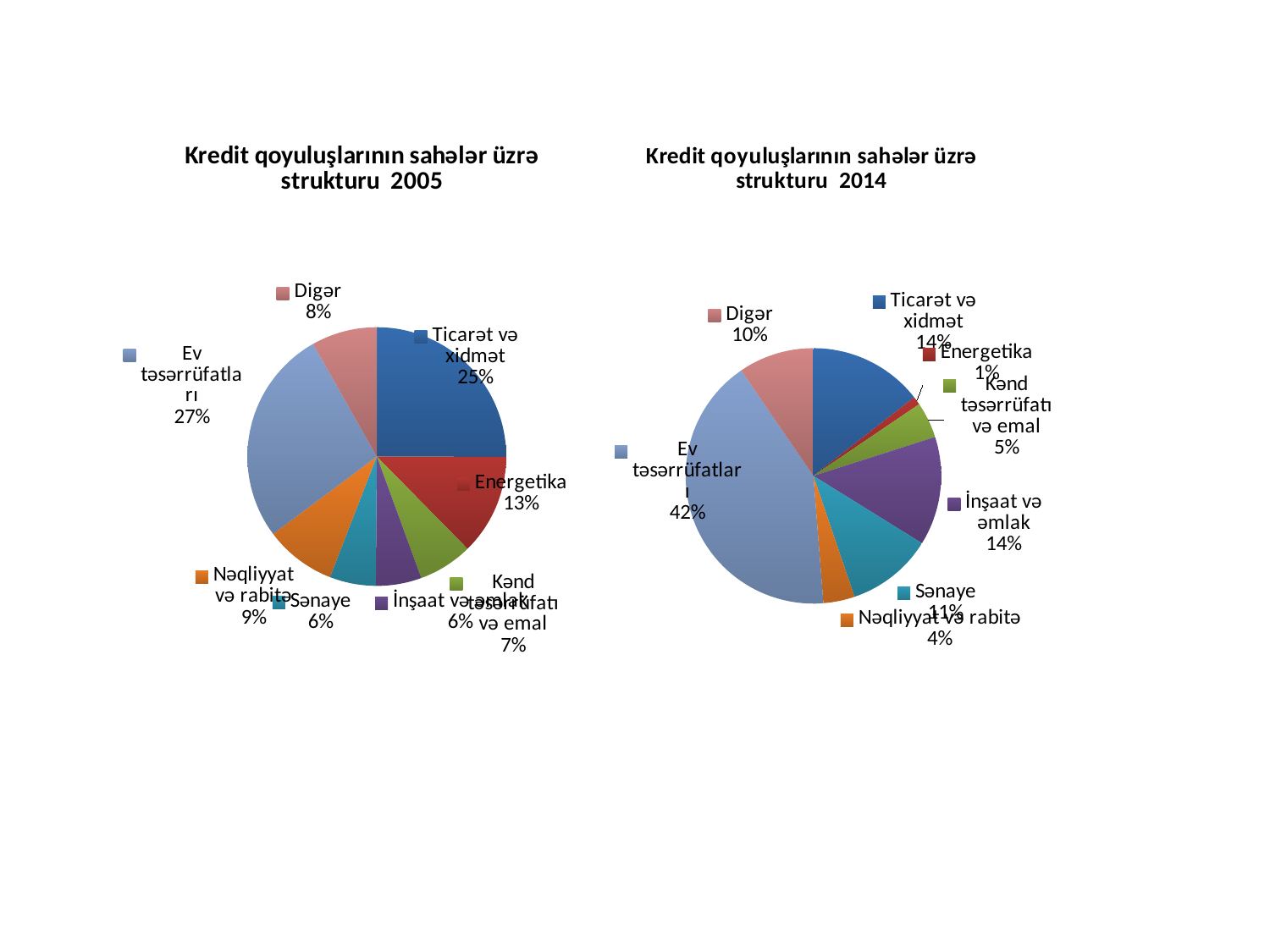
In the 2014 chart, which sector has the smallest share? Energetika In the 2005 chart (Kredit qoyuluşlarının sahələr üzrə strukturu 2005), what share does Ev təsərrüfatları have? 27% What type of chart is used on the slide for the 2005 data? Pie chart How many sectors are shown in the 2014 chart? 8 In the 2014 chart, what share does Energetika have? 1% In the 2014 chart, which is larger: the share of Sənaye or the share of Nəqliyyat və rabitə? Sənaye In the 2005 chart, what share does Ticarət və xidmət have? 25% In the 2005 chart, what is the difference between the shares of Ev təsərrüfatları and Ticarət və xidmət? 2% In the 2005 chart, what share does Energetika have? 13% In the 2005 chart, which sector has the largest share? Ev təsərrüfatları In the 2014 chart, which sector has the largest share? Ev təsərrüfatları In the 2014 chart (Kredit qoyuluşlarının sahələr üzrə strukturu 2014), what share does Ev təsərrüfatları have? 42%